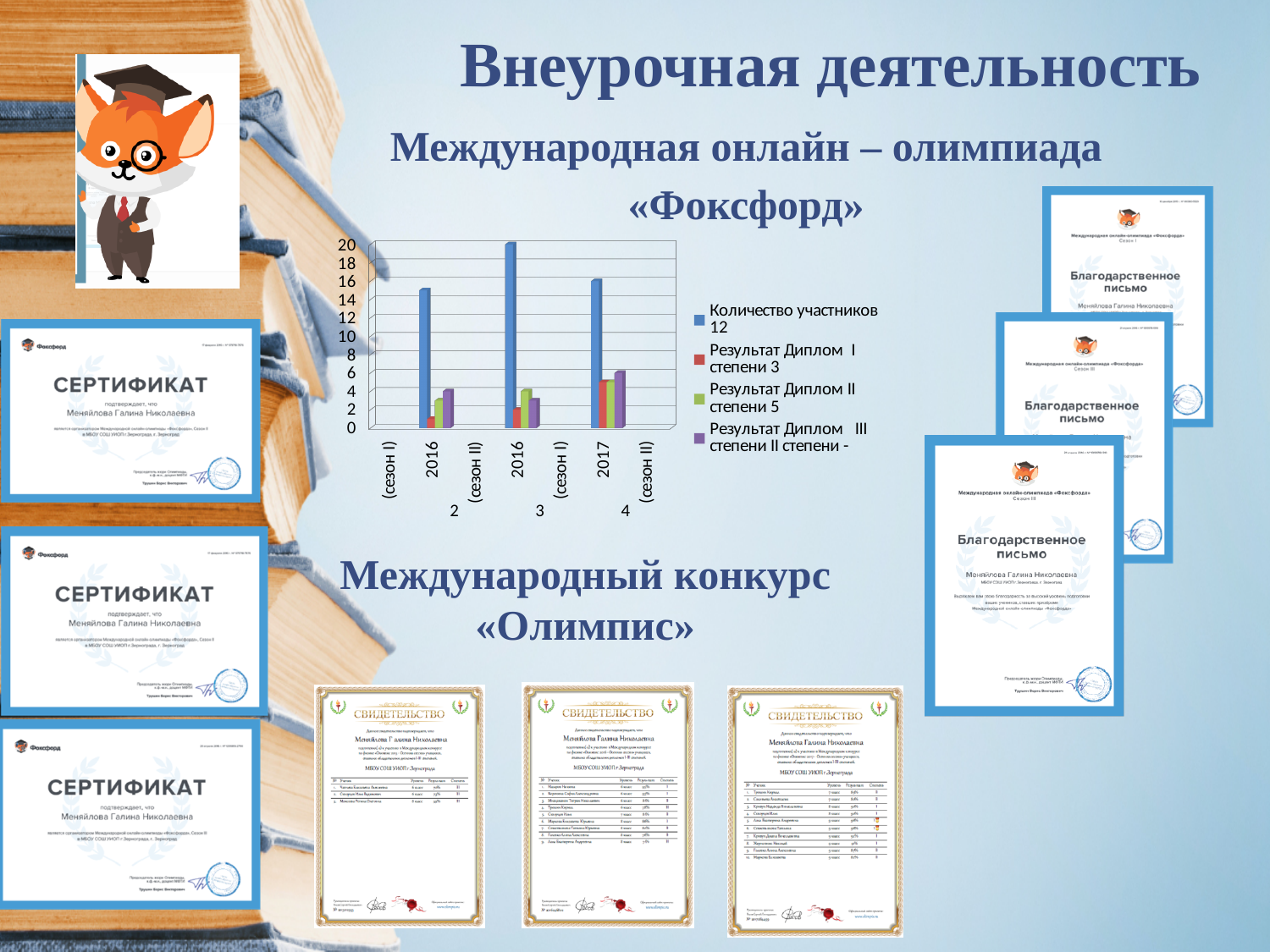
What is the first legend entry of the «Фоксфорд» chart? Количество участников 12 In the «Фоксфорд» chart, is the «Результат Диплом I степени» value for 2016 (сезон I) greater or less than 4? less What colour represents «Количество участников» in the «Фоксфорд» chart? blue How many series does the legend of the «Фоксфорд» chart list? 4 In the «Фоксфорд» chart, which is larger: «Результат Диплом I степени» for 2017 (сезон I) or for 2016 (сезон I)? 2017 (сезон I) In the «Фоксфорд» chart, is the «Количество участников» value for 2016 (сезон II) greater or less than 18? greater How many category groups are plotted on the x axis of the «Фоксфорд» chart? 3 In the «Фоксфорд» chart, which category has the highest value for «Результат Диплом I степени»? 2017 (сезон I) In the «Фоксфорд» chart, is the «Количество участников» value for 2016 (сезон I) greater or less than 12? greater What kind of chart is shown under the heading «Фоксфорд»? bar chart In the «Фоксфорд» chart, which category has the highest value for «Количество участников»? 2016 (сезон II) In the «Фоксфорд» chart, which is larger: «Количество участников» for 2016 (сезон II) or for 2017 (сезон I)? 2016 (сезон II)